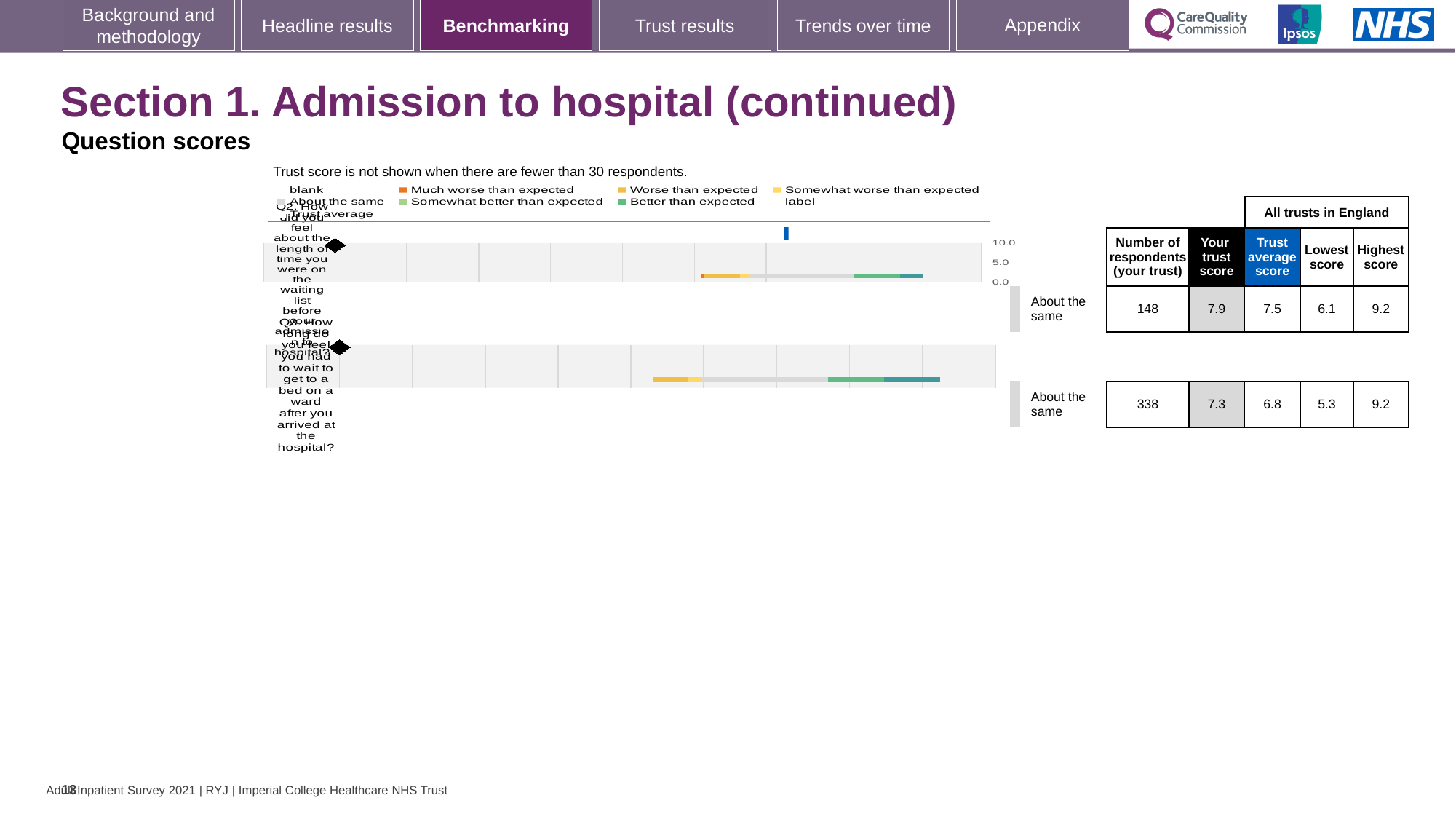
What is the trust average score across all trusts in England for Q3? 6.8 Which question has the higher 'Your trust score', Q2 or Q3? Q2 What benchmark category is shown next to the Q2 bar? About the same What is the difference between the highest and lowest scores across all trusts in England for Q3? 3.9 What is the lowest score among all trusts in England for Q2? 6.1 What kind of chart is used to show the question scores on this slide? bar chart How many questions are plotted in the question scores chart? 2 How many respondents from your trust answered Q3? 338 How many respondents from your trust answered Q2? 148 What is the 'Your trust score' for Q2 (how did you feel about the length of time on the waiting list)? 7.9 What is the 'Your trust score' for Q3 (how long did you feel you had to wait to get to a bed on a ward)? 7.3 What is the difference between your trust score and the trust average score for Q2? 0.4